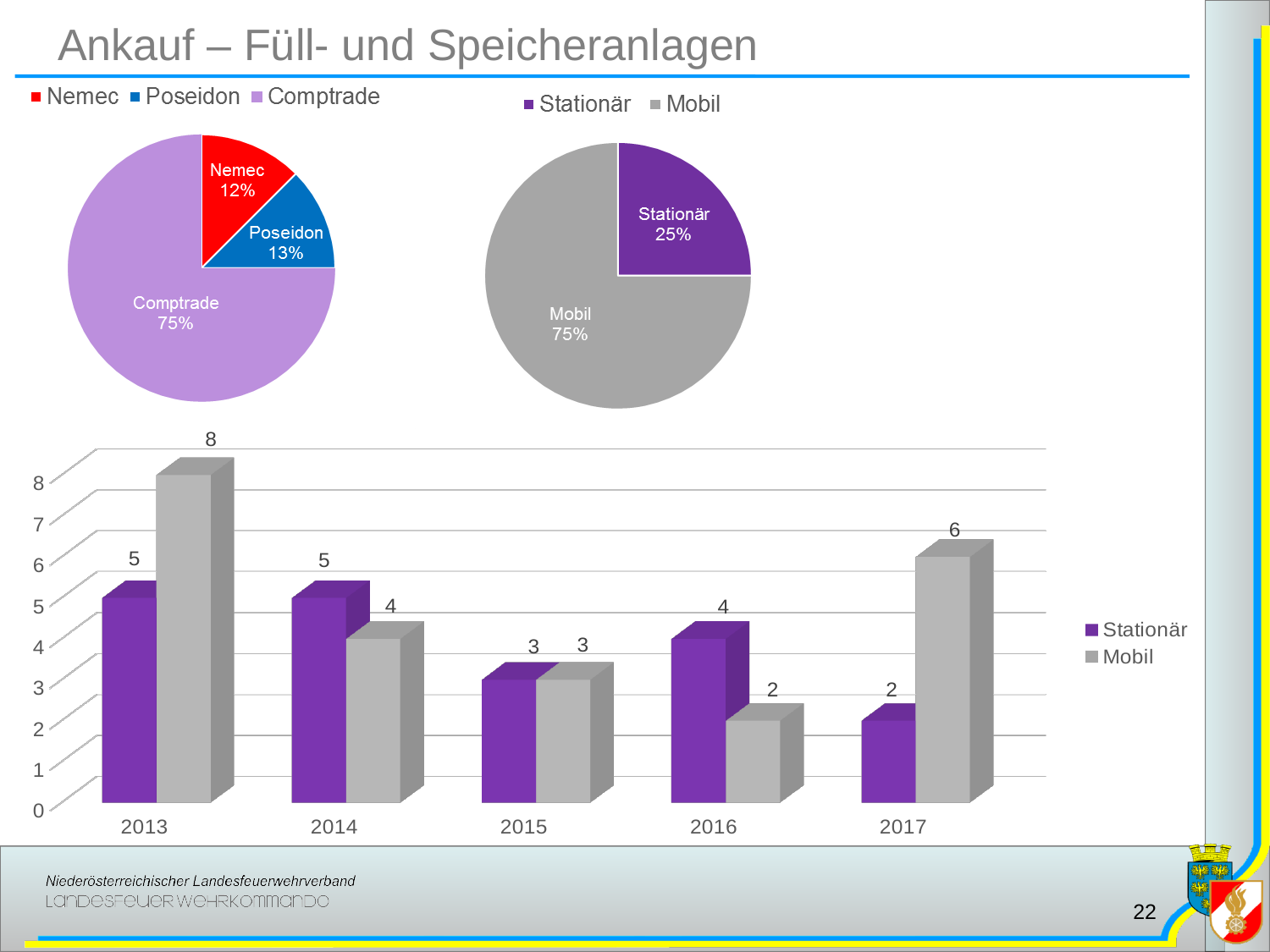
In the bottom bar chart, how many years are shown on the x axis? 5 In the right pie chart, what share does Stationär have? 25% In the bottom bar chart, which is larger in 2016, Stationär or Mobil? Stationär In the left pie chart, what share does Comptrade have? 75% In the bottom bar chart, which year has the highest Mobil value? 2013 In the left pie chart, which slice is the largest? Comptrade In the bottom bar chart, what is the value for Mobil in 2013? 8 In the left pie chart, what share does Nemec have? 12% In the bottom bar chart, what is the value for Stationär in 2017? 2 In the right pie chart, which slice is the smallest? Stationär What kind of chart is the bottom chart? Bar chart In the bottom bar chart, what is the difference between Mobil and Stationär in 2017? 4